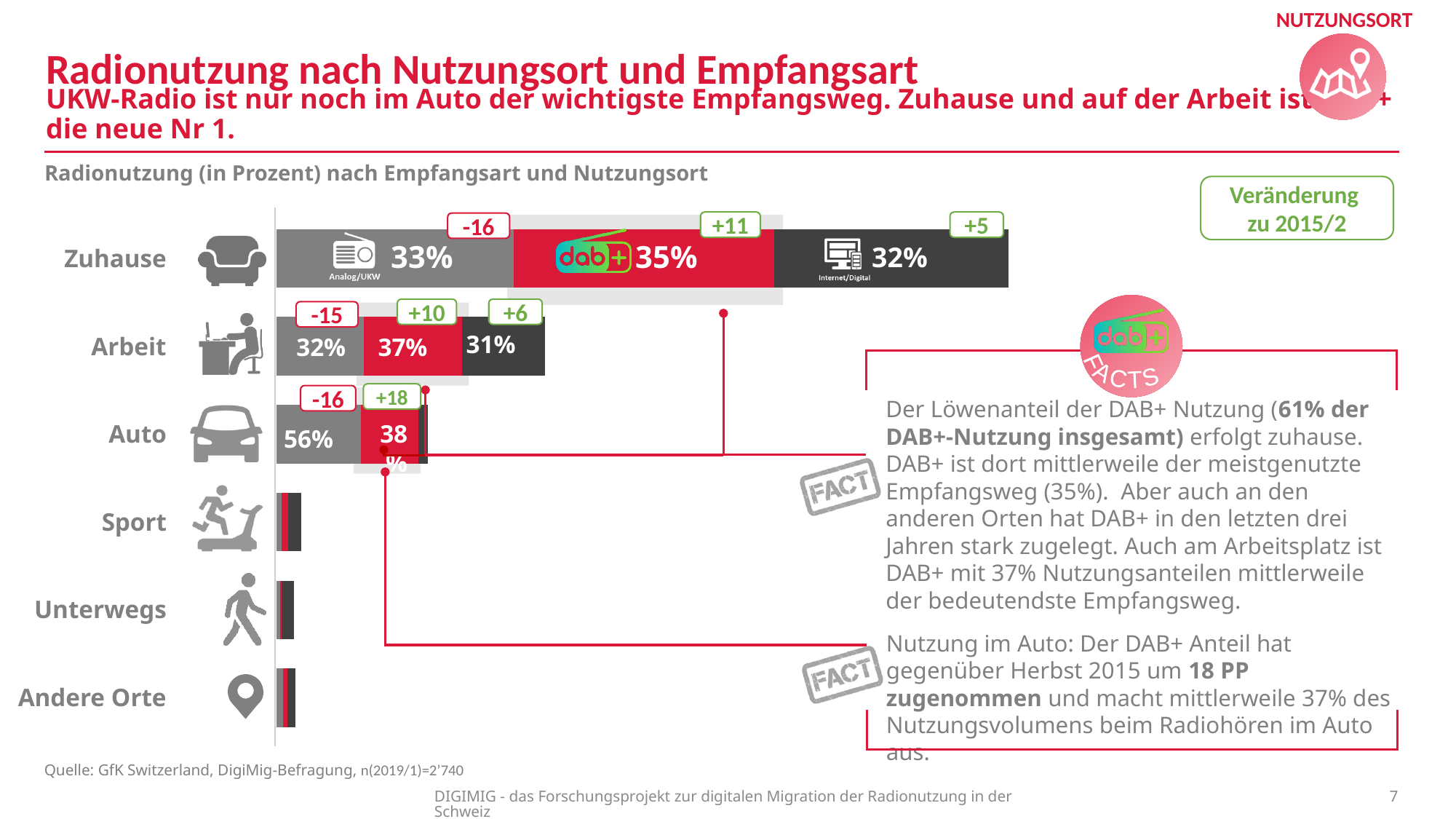
How many usage locations (categories) are listed on the chart? 6 What is the difference between the Analog/UKW share and the DAB+ share for Auto? 18% What is the Internet/Digital share for Zuhause? 32% Which reception type has the highest share for Zuhause? DAB+ What kind of chart is shown on the slide? bar chart Which reception type has the lowest share for Arbeit? Internet/Digital Which is larger for Arbeit: the Analog/UKW share or the DAB+ share? DAB+ What is the Analog/UKW share for Zuhause? 33% What is the Analog/UKW share for Auto? 56% What is the DAB+ share for Arbeit? 37% What is the change versus 2015/2 shown for Analog/UKW in the Arbeit category? -15 What is the change versus 2015/2 shown for DAB+ in the Auto category? +18